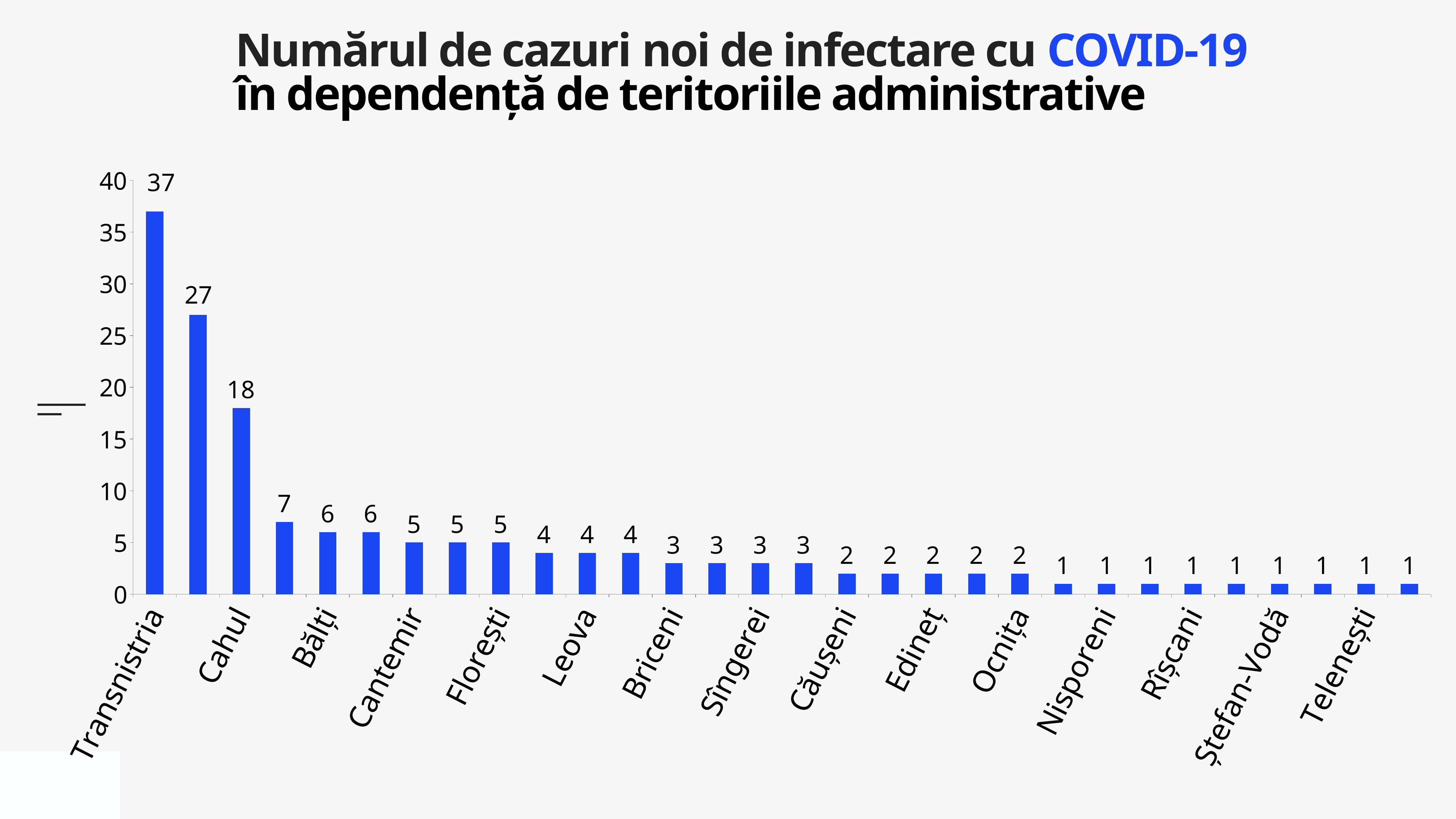
Is the value for Transnistria greater or less than 35? greater How many bars are plotted in the chart? 30 What is the value of the tallest bar? 37 What is the highest tick value on the vertical axis? 40 What is the smallest value shown on any bar? 1 What colour are the bars in the chart? blue What is the difference between the tallest bar (37) and the second tallest bar (27)? 10 Which territory has the highest number of new cases? Transnistria What kind of chart is shown on the slide? bar chart What is the value for Transnistria? 37 Do the values rise or fall from left to right along the x axis? fall What is the value of the second tallest bar? 27